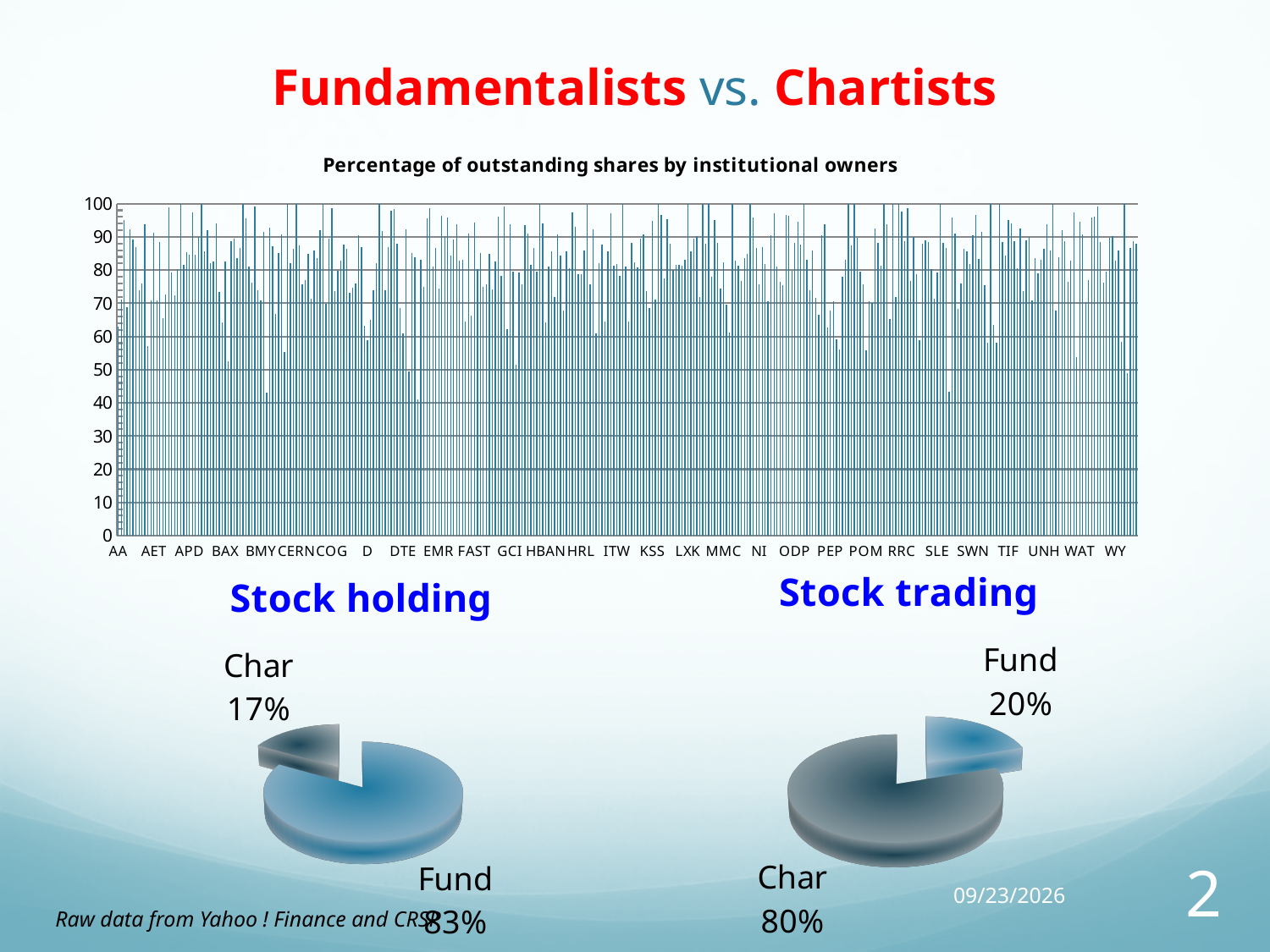
In the 'Stock holding' pie chart, what share does Char have? 17% In the 'Stock holding' pie chart, which slice is larger, Char or Fund? Fund What is the title of the top chart on the slide? Percentage of outstanding shares by institutional owners In the 'Stock trading' pie chart, what is the difference between the Char share and the Fund share? 60% What kind of chart is the top chart titled 'Percentage of outstanding shares by institutional owners'? bar chart What kind of chart is the 'Stock holding' chart? pie chart How many slices does the 'Stock holding' pie chart have? 2 In the 'Stock holding' pie chart, what share does Fund have? 83% In the 'Stock trading' pie chart, which slice is the largest? Char In the 'Stock trading' pie chart, what share does Fund have? 20% In the top bar chart, what is the highest value shown on the vertical axis? 100